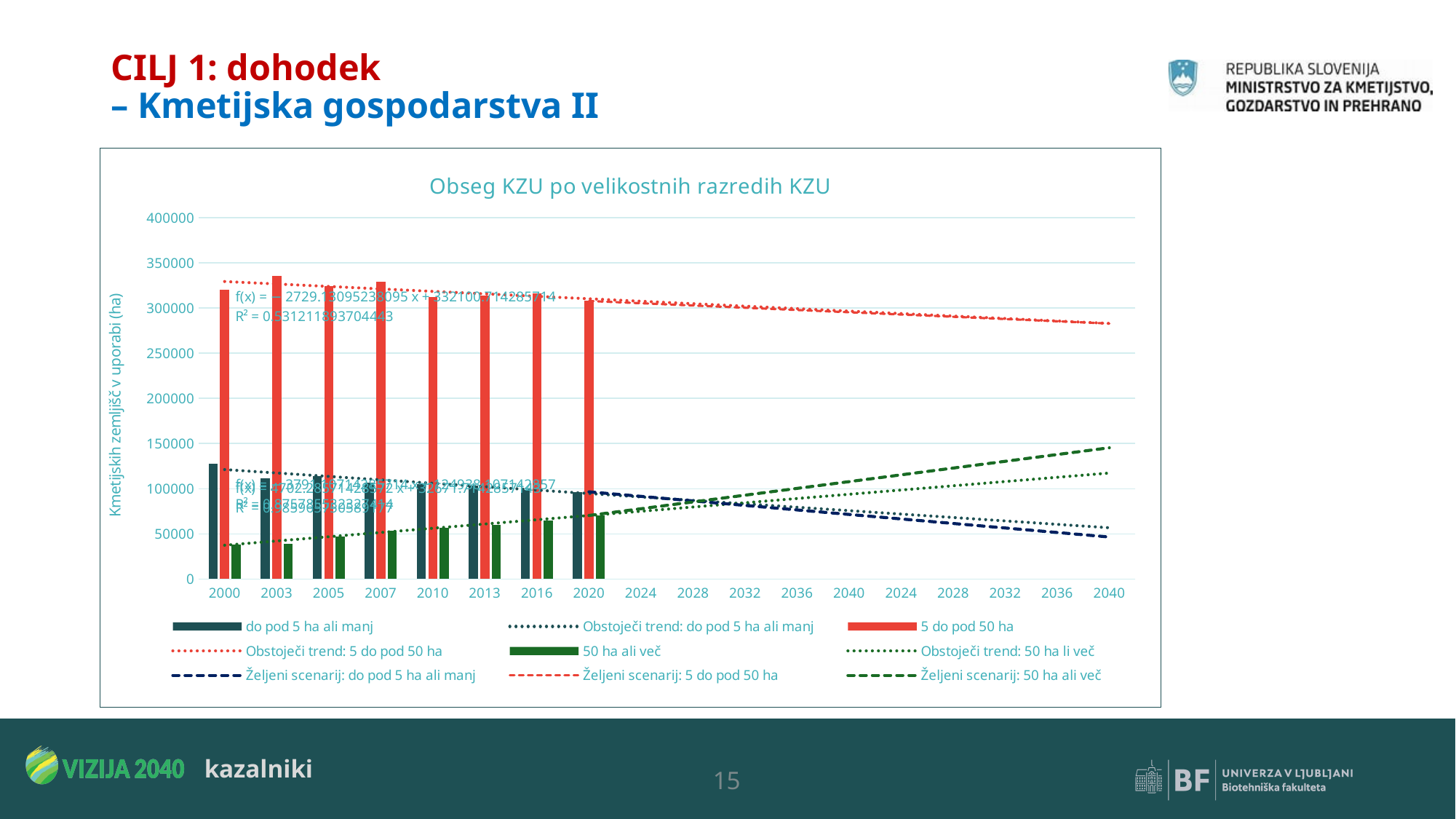
In 2000, which is larger: the bar for 'do pod 5 ha ali manj' or the bar for '50 ha ali več'? do pod 5 ha ali manj Is the value for '50 ha ali več' in 2000 greater or less than 50000? less Which year has the highest bar for the series '5 do pod 50 ha'? 2003 Which year has the highest bar for the series '50 ha ali več'? 2020 Is the value for '5 do pod 50 ha' in 2003 greater or less than 300000? greater Do the bars for '50 ha ali več' rise or fall from 2000 to 2020? rise Is the value for 'do pod 5 ha ali manj' in 2000 greater or less than 100000? greater What is the title of the chart? Obseg KZU po velikostnih razredih KZU How many entries does the chart legend list? 9 What kind of chart is shown on the slide? combination bar and line chart Which year has the highest bar for the series 'do pod 5 ha ali manj'? 2000 For how many years are bars plotted in the chart? 8